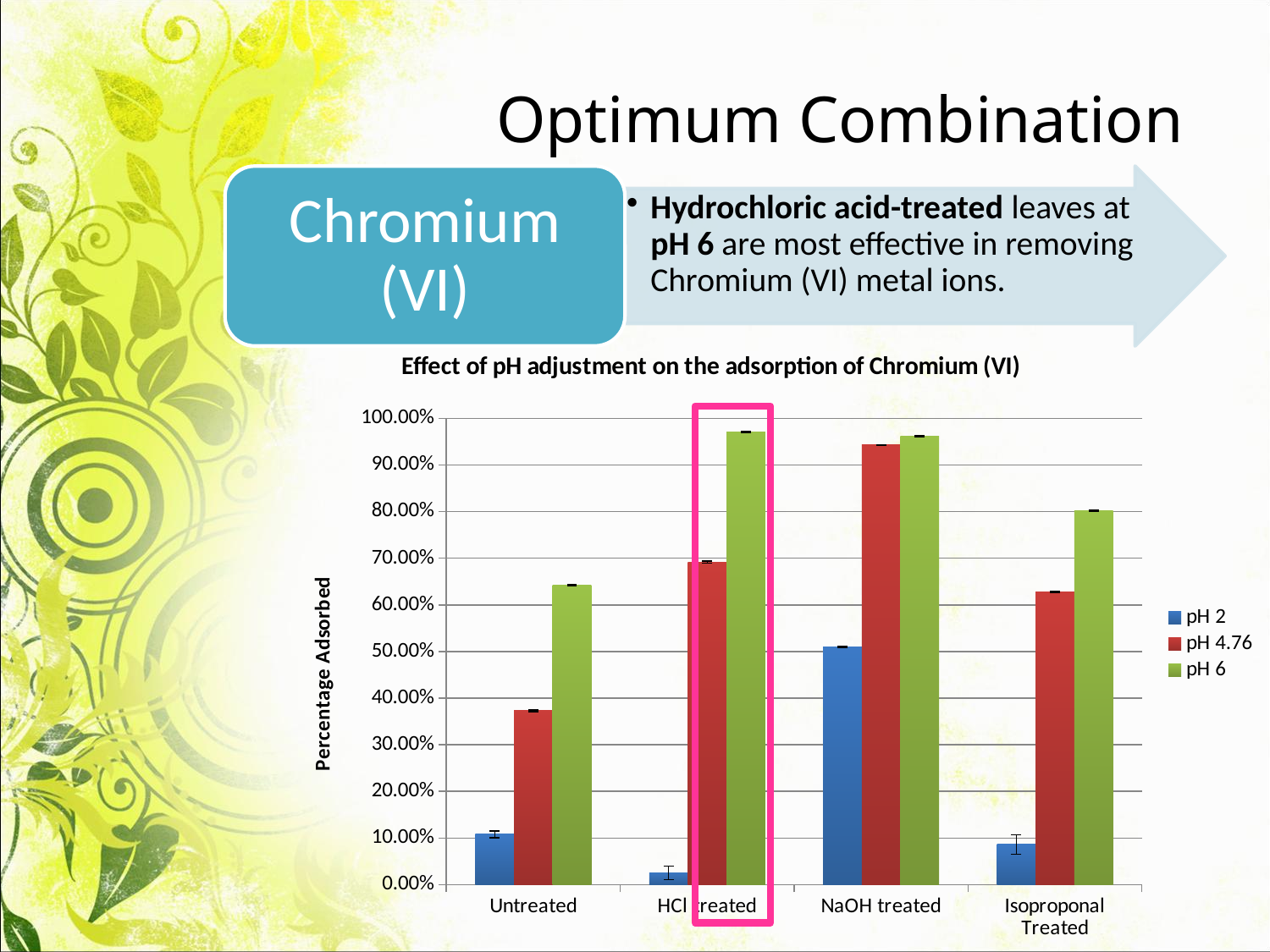
How many treatment categories are shown on the x axis? 4 What is the label of the y axis? Percentage Adsorbed What is the title of the chart? Effect of pH adjustment on the adsorption of Chromium (VI) How many series does the legend list? 3 What type of chart is shown on the slide? bar chart Is the pH 4.76 value for Isoproponal Treated greater or less than 50.00%? greater Which is larger for Untreated: the pH 4.76 value or the pH 6 value? pH 6 Is the pH 6 value for HCl treated greater or less than 90.00%? greater Which treatment category has the highest pH 2 value? NaOH treated Which treatment category has the lowest pH 6 value? Untreated Is the pH 2 value for Untreated greater or less than 20.00%? less Which treatment category has the highest pH 4.76 value? NaOH treated